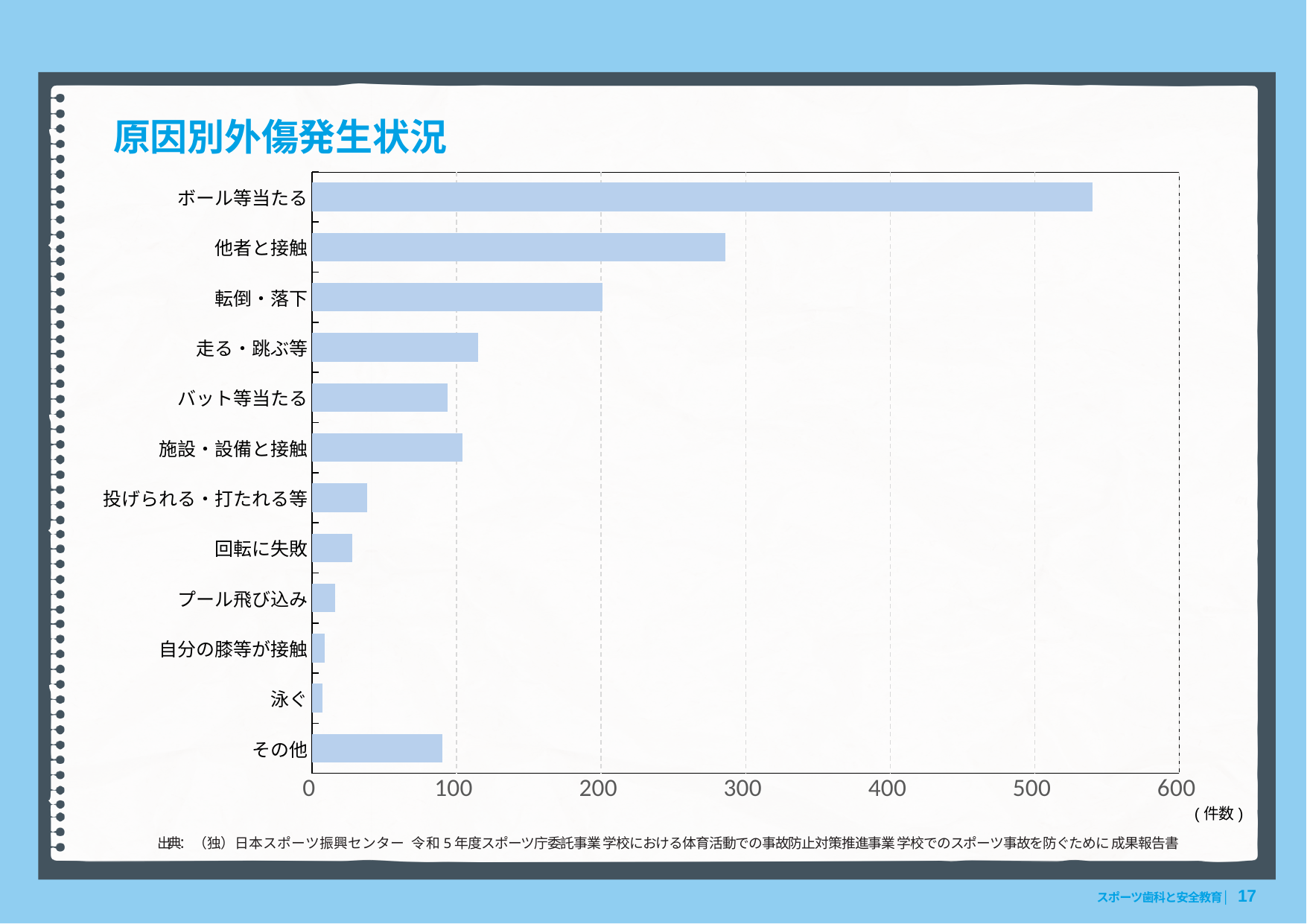
What is the title of the chart? 原因別外傷発生状況 What unit is indicated for the horizontal axis of the chart? 件数 Is the value for ボール等当たる greater or less than 500? greater Is the value for 他者と接触 greater or less than 300? less Which is larger, the value for 他者と接触 or the value for 転倒・落下? 他者と接触 Is the value for その他 greater or less than 100? less What kind of chart is shown on the slide? bar chart Which is larger, the value for 走る・跳ぶ等 or the value for バット等当たる? 走る・跳ぶ等 How many categories are plotted in the chart? 12 Which category has the highest value? ボール等当たる